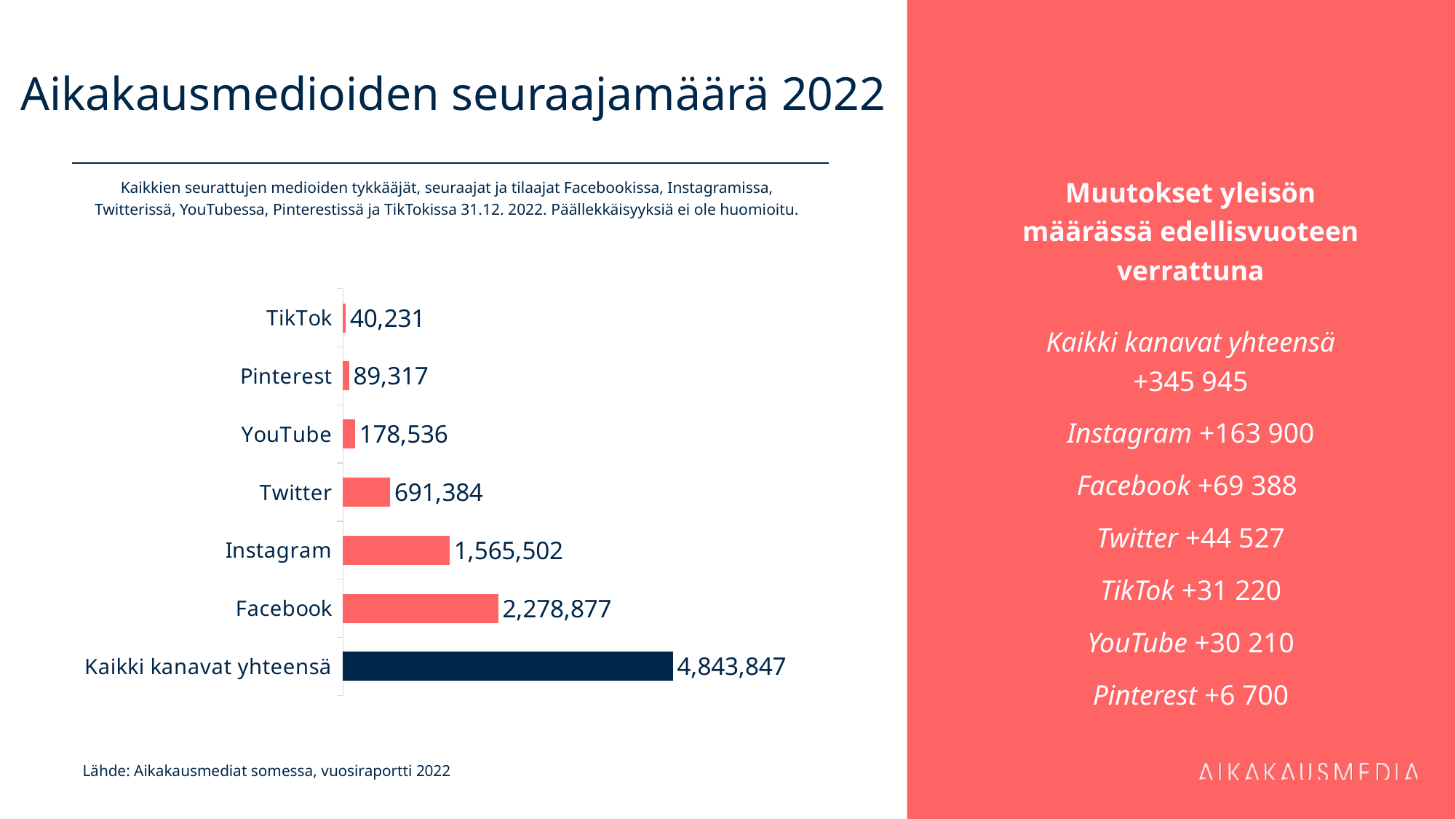
Which has a larger value, Pinterest or YouTube? YouTube What value is shown for Instagram in the bar chart? 1,565,502 What is the difference between the Twitter and YouTube values? 512,848 Which individual channel (excluding the total bar) has the highest value? Facebook How many bars are shown in the chart? 7 What type of chart is shown on the slide? Bar chart Which category has the lowest value in the chart? TikTok What is the difference between the Facebook and Instagram values? 713,375 What is the value for Kaikki kanavat yhteensä? 4,843,847 What is the number of followers shown for Facebook? 2,278,877 Which bar is shown in a different (dark navy) colour from the others? Kaikki kanavat yhteensä What is the value shown for TikTok? 40,231